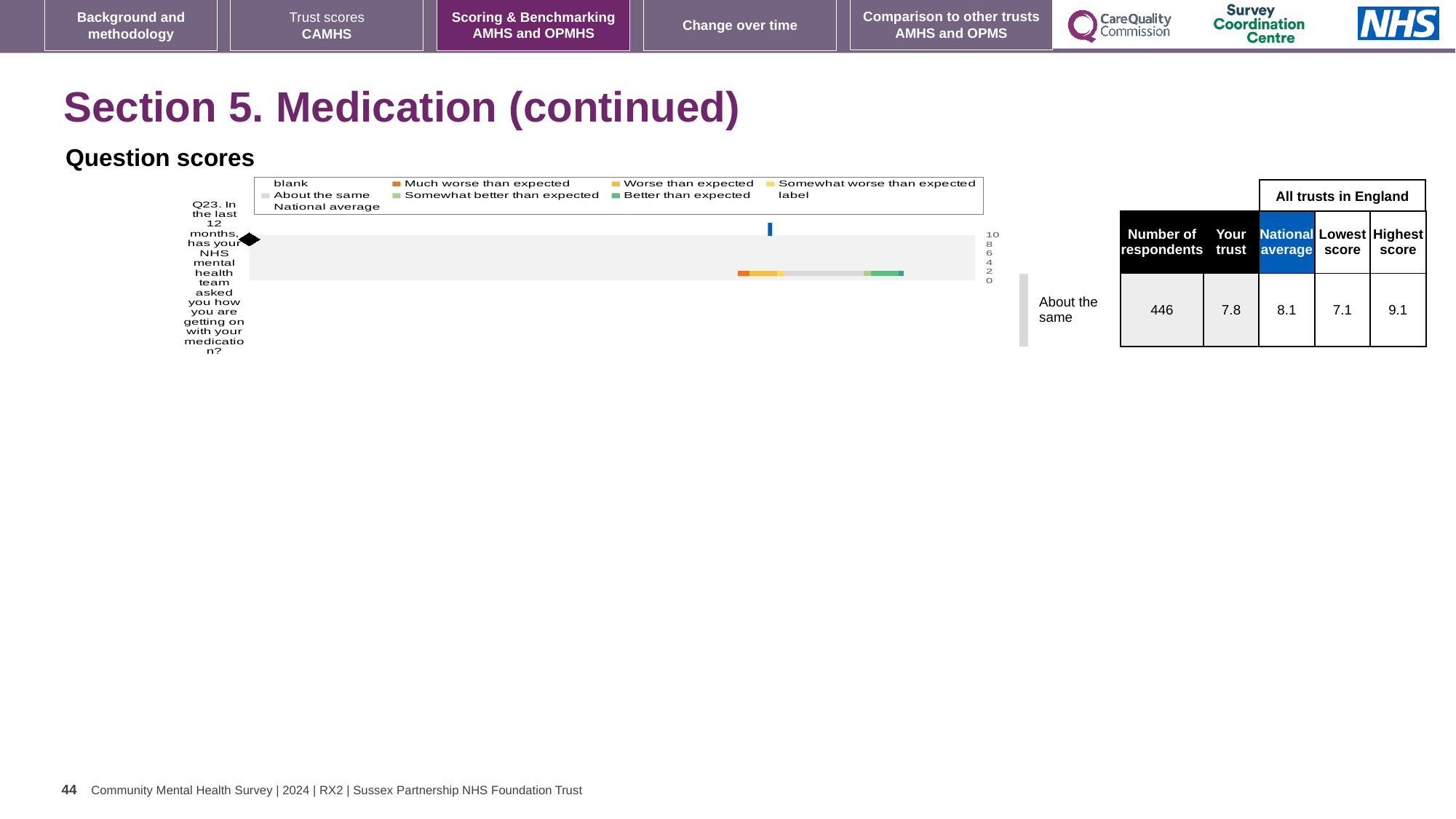
Which question number is plotted in the chart? Q23 Which is larger for Q23: the 'Your trust' score or the national average? National average How many survey questions (categories) are plotted in the chart? 1 What is the highest value shown on the chart's axis? 10 Is the national average marker for Q23 greater or less than 6 on the axis? greater What is the national average score for Q23 in the table beside the chart? 8.1 What is the difference between the highest score (9.1) and the lowest score (7.1) for Q23? 2.0 What benchmark category is the trust's Q23 score labelled as? About the same What is the number of respondents for Q23? 446 What is the 'Your trust' score for Q23 in the table beside the chart? 7.8 What kind of chart is shown on the slide? bar chart What is the heading above the chart? Question scores